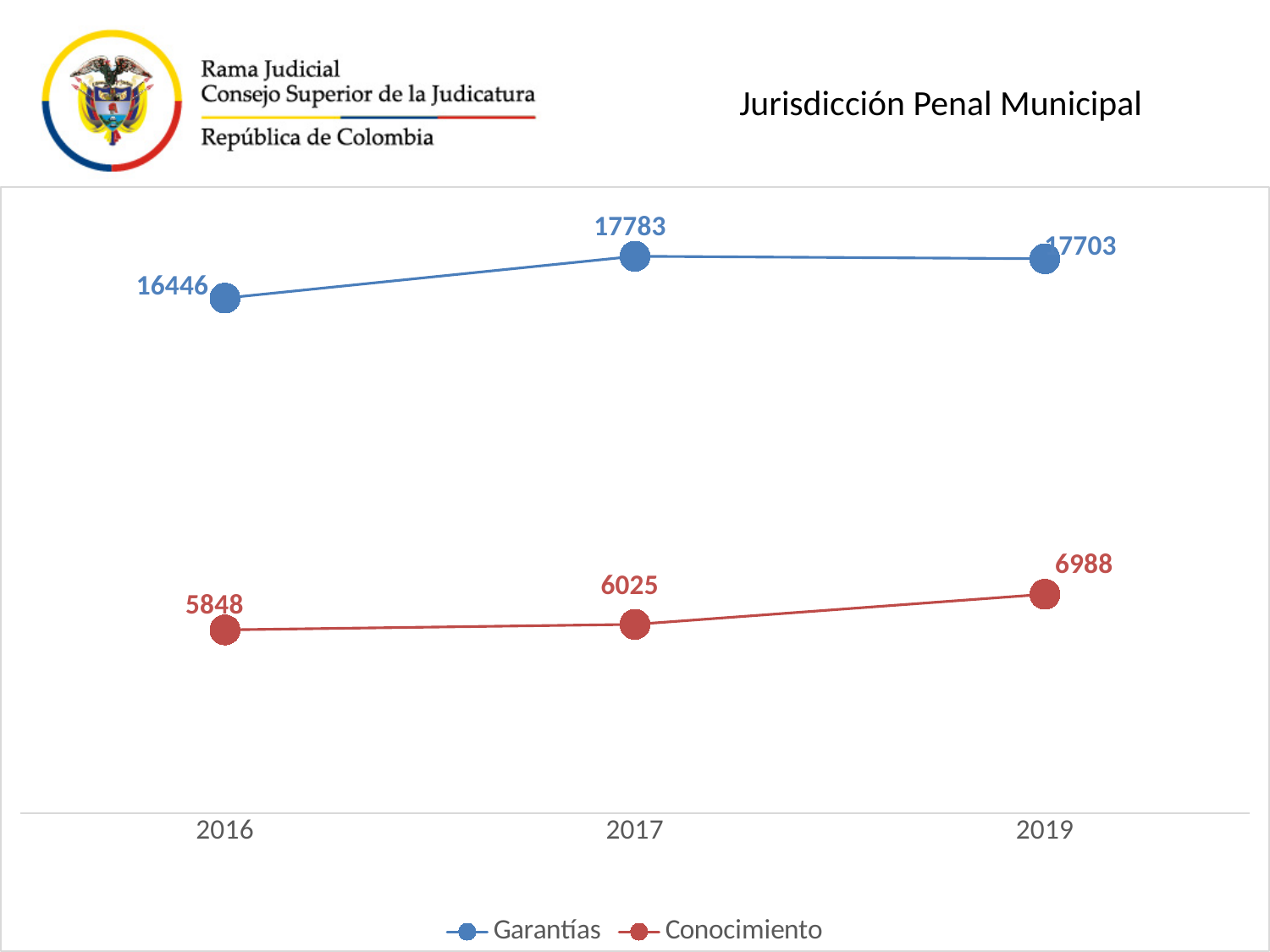
How many years are shown on the x axis? 3 What is the value for Garantías in 2016? 16446 What is the difference between Garantías in 2017 and Garantías in 2016? 1337 What is the value for Conocimiento in 2019? 6988 What is the value for Garantías in 2017? 17783 In which year is Garantías highest? 2017 How many series does the legend list? 2 In which year is Conocimiento lowest? 2016 What kind of chart is shown? line chart What is the difference between Garantías and Conocimiento in 2019? 10715 What is the value for Conocimiento in 2017? 6025 Which is larger in 2016, Garantías or Conocimiento? Garantías